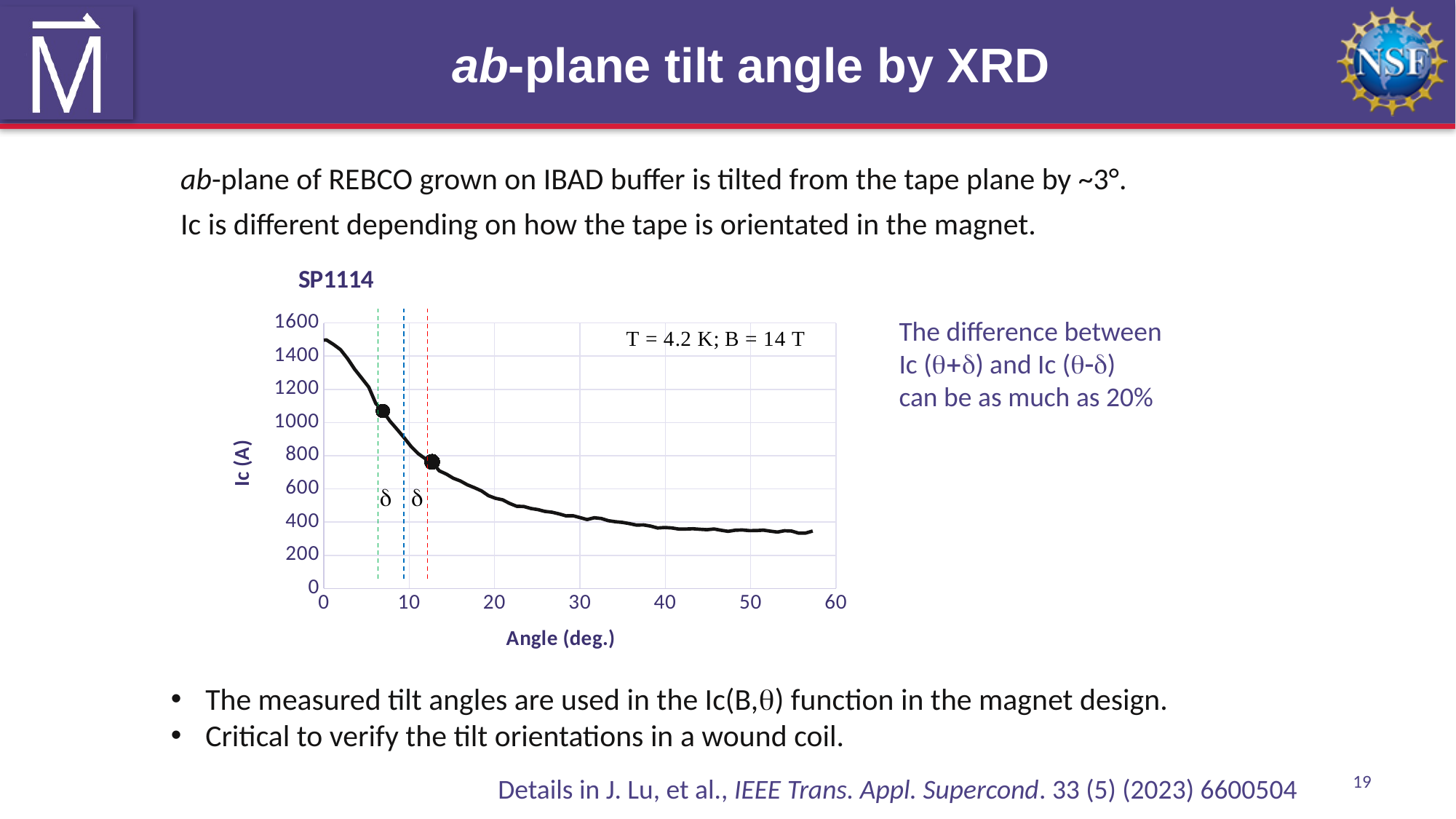
Is the value of Ic at an angle of 30 degrees greater or less than 600? less Is the value of Ic at an angle of 40 degrees greater or less than 200? greater Which is larger, Ic at 10 degrees or Ic at 40 degrees? Ic at 10 degrees Is the value of Ic at an angle of 20 degrees greater or less than 800? less What kind of chart is shown on the slide? line chart What is the label of the y axis of the chart? Ic (A) At which angle on the x axis is Ic highest? 0 How many highlighted dot markers are drawn on the curve? 2 What is the title of the chart? SP1114 Does Ic rise or fall as the angle increases along the x axis? fall